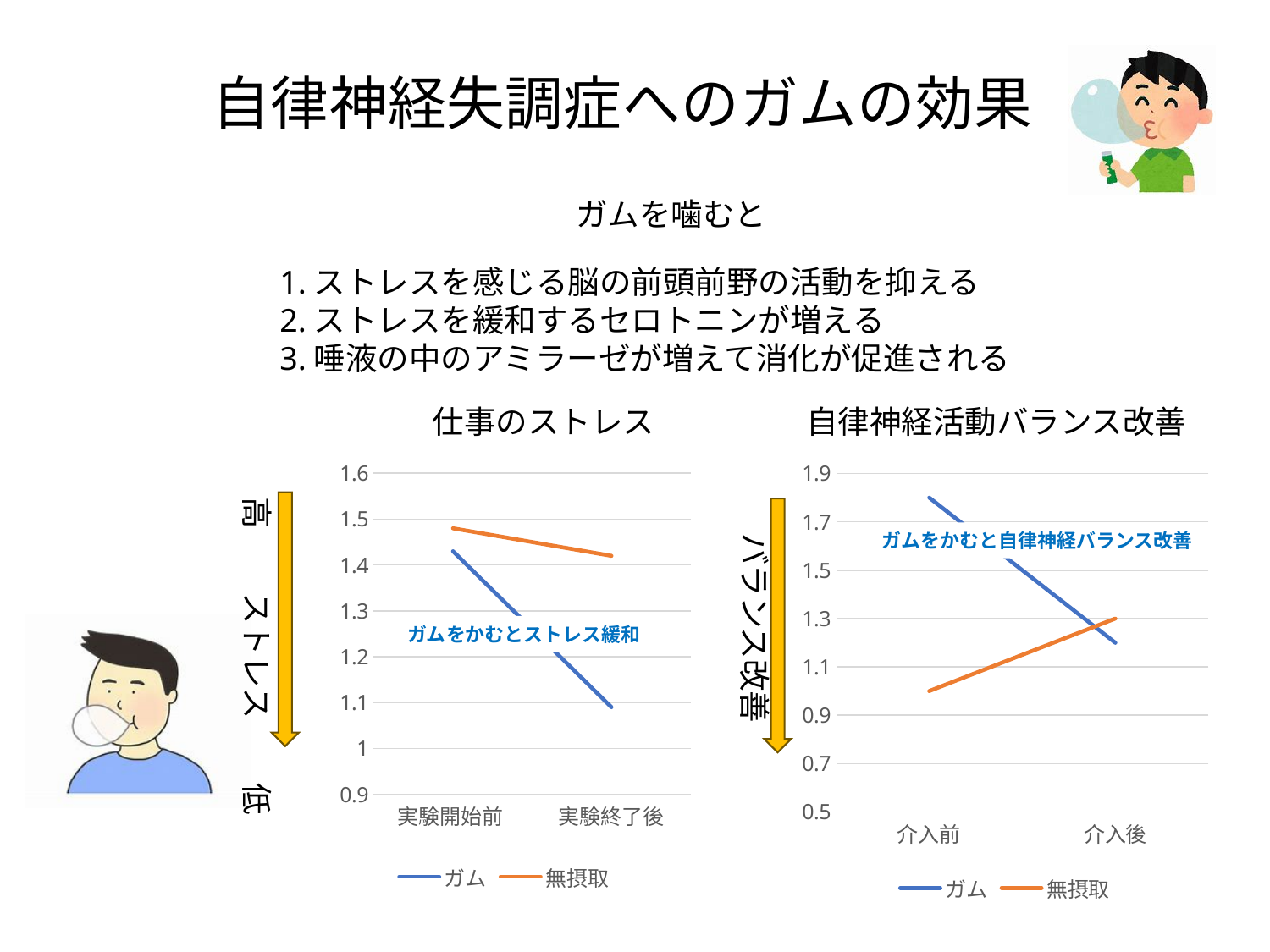
In the 自律神経活動バランス改善 chart, which series has the larger value at 介入前, ガム or 無摂取? ガム What colour is the ガム line in the 自律神経活動バランス改善 chart? blue In the 自律神経活動バランス改善 chart, is the value for 無摂取 at 介入前 greater or less than 1.1? less In the 仕事のストレス chart, does the ガム line rise or fall from 実験開始前 to 実験終了後? fall In the 自律神経活動バランス改善 chart, is the value for ガム at 介入前 greater or less than 1.7? greater In the 仕事のストレス chart, how many points are on the x axis? 2 In the 自律神経活動バランス改善 chart, does the 無摂取 line rise or fall from 介入前 to 介入後? rise What kind of chart is the 仕事のストレス chart? line chart In the 仕事のストレス chart, which series has the larger value at 実験終了後, ガム or 無摂取? 無摂取 How many series does the legend of the 仕事のストレス chart list? 2 In the 仕事のストレス chart, is the value for 無摂取 at 実験開始前 greater or less than 1.4? greater